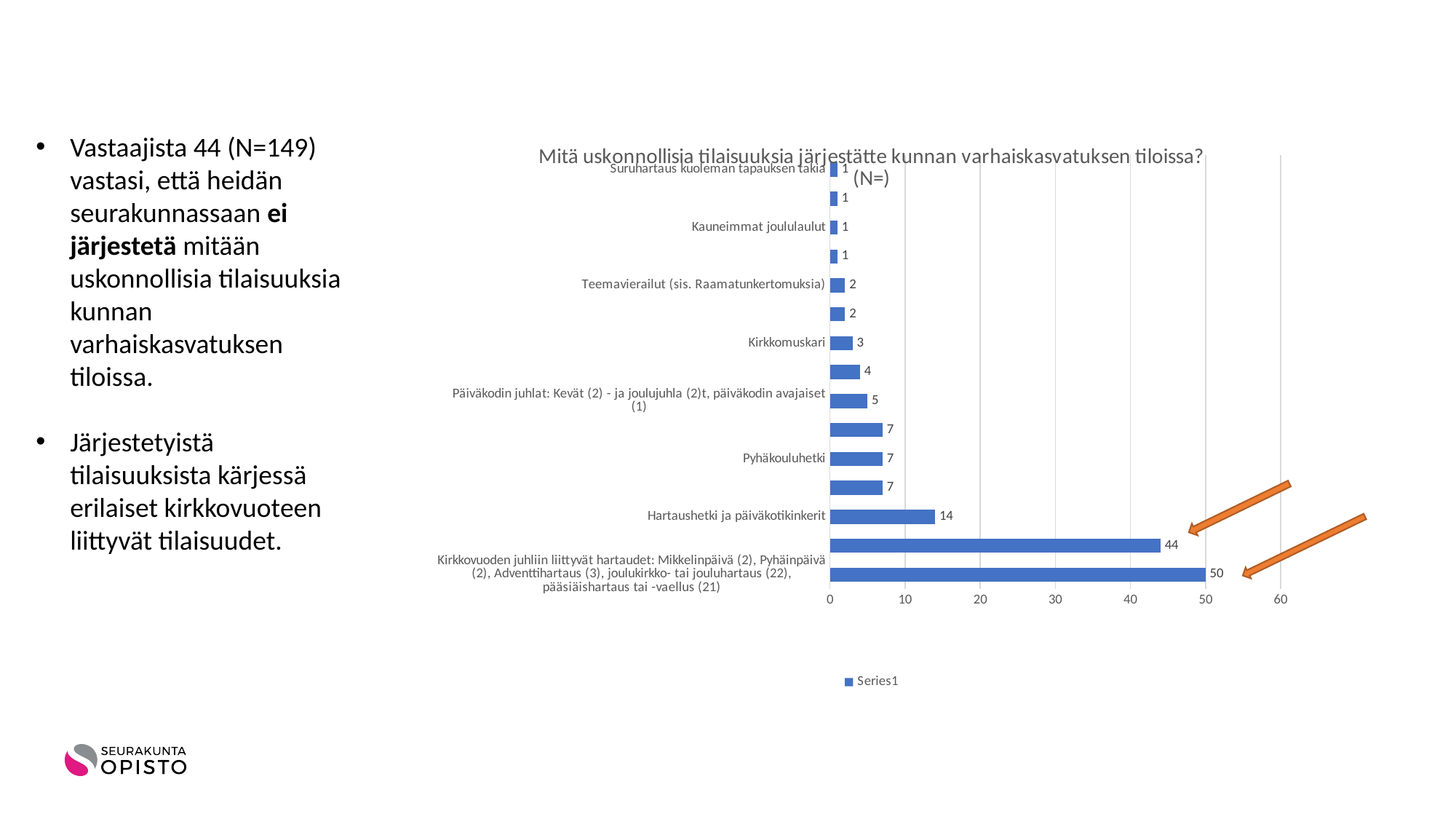
Which category has the highest value? Kirkkovuoden juhliin liittyvät hartaudet: Mikkelinpäivä (2), Pyhäinpäivä (2), Adventtihartaus (3), joulukirkko- tai jouluhartaus (22), pääsiäishartaus tai -vaellus (21) What is the value for Hartaushetki ja päiväkotikinkerit? 14 Which is larger, the value for Hartaushetki ja päiväkotikinkerit or the value for Pyhäkouluhetki? Hartaushetki ja päiväkotikinkerit What is the value for Pyhäkouluhetki? 7 What is the value for Teemavierailut (sis. Raamatunkertomuksia)? 2 How many bars are plotted in the chart? 15 What is the value for Kirkkomuskari? 3 Is the value for Hartaushetki ja päiväkotikinkerit greater or less than 10? greater What is the difference between the value for Kirkkovuoden juhliin liittyvät hartaudet and the value for Hartaushetki ja päiväkotikinkerit? 36 What kind of chart is shown on the slide? bar chart What is the value for Kauneimmat joululaulut? 1 How many series does the legend list? 1